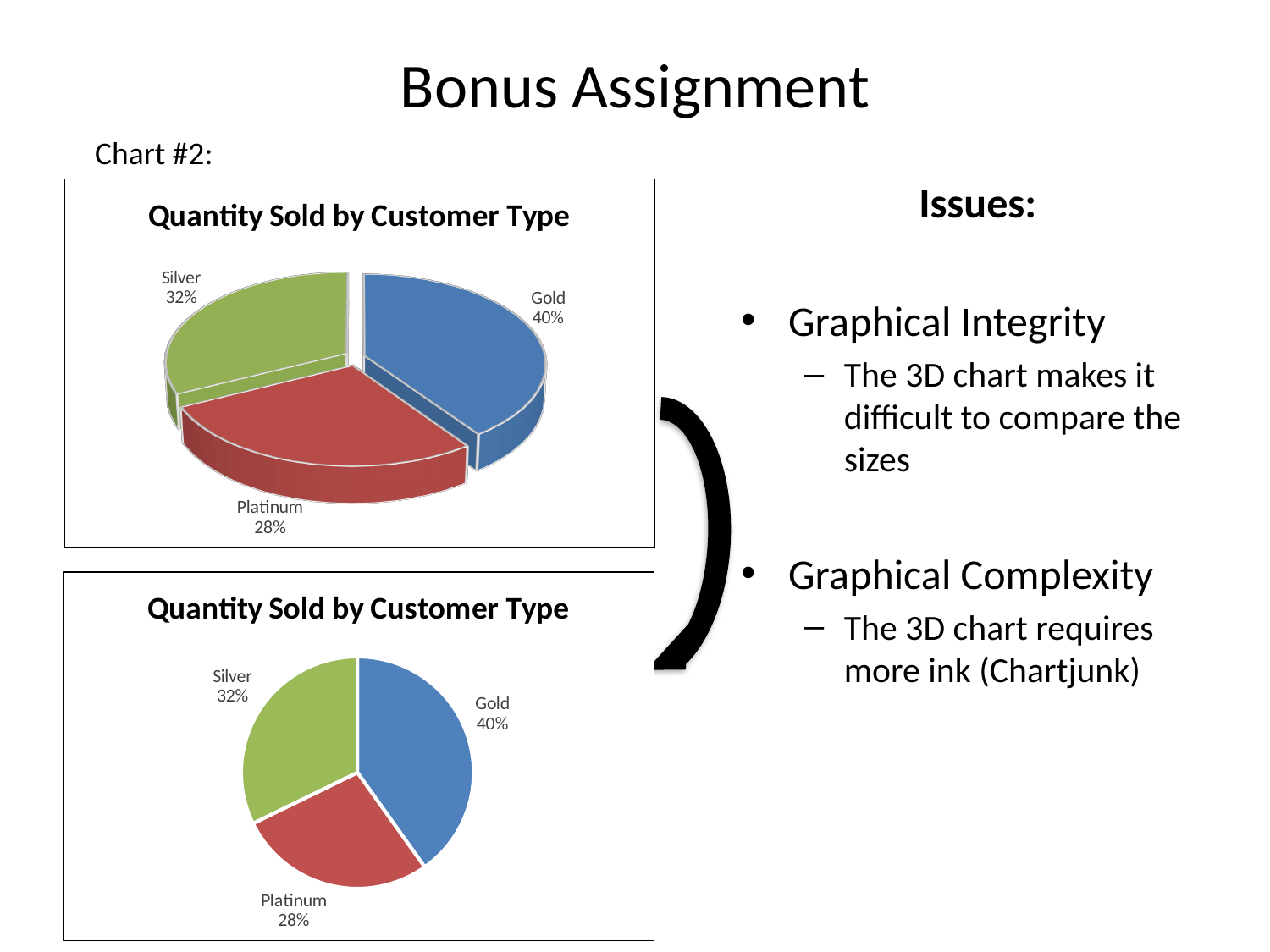
What kind of chart is the top chart on the slide? 3D pie chart In the bottom pie chart, what share of quantity sold is Platinum? 28% How many customer types are shown in the bottom pie chart? 3 In the top pie chart, what share of quantity sold is Gold? 40% In the bottom pie chart, which is larger, the Silver share or the Platinum share? Silver In the top pie chart, what share of quantity sold is Silver? 32% In the bottom pie chart, which customer type has the largest share? Gold In the bottom pie chart, what colour is the Silver slice? Green In the top pie chart, what is the difference between the Silver and Platinum shares? 4% In the bottom pie chart, what is the difference between the Gold and Platinum shares? 12% What is the title of the bottom chart? Quantity Sold by Customer Type In the top pie chart, which customer type has the smallest share? Platinum